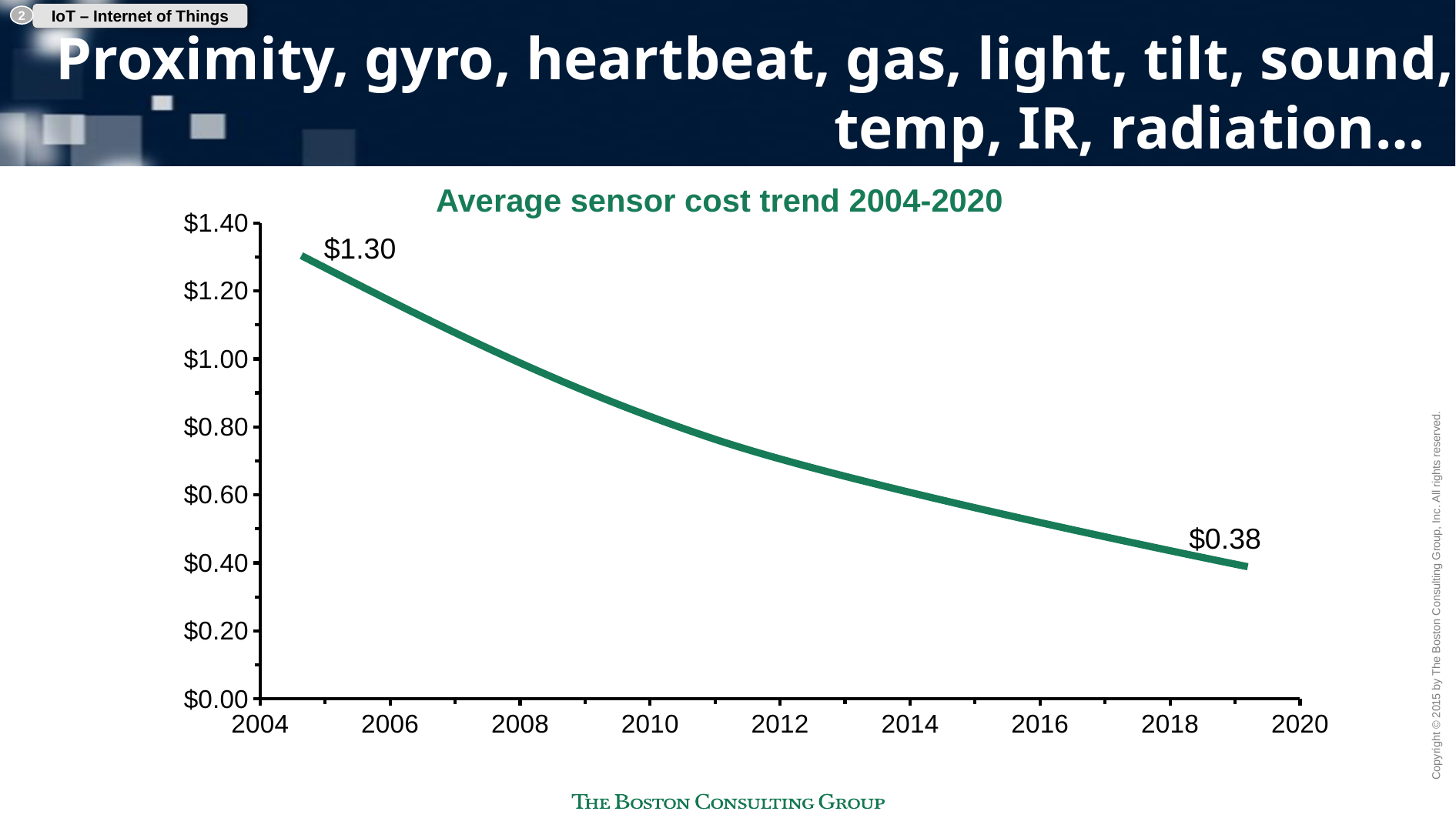
What is the difference between the starting value ($1.30) and the ending value ($0.38) of the line? $0.92 Is the value for 2010 greater or less than $1.00? less Does the average sensor cost rise or fall from 2004 to 2020? fall Is the value for 2006 greater or less than $1.00? greater What is the highest value labelled on the chart? $1.30 What is the value labelled at the end of the line? $0.38 What is the title of the chart? Average sensor cost trend 2004-2020 What is the value labelled at the start of the line? $1.30 What kind of chart is shown on the slide? line chart What is the lowest value labelled on the chart? $0.38 What is the maximum value shown on the y axis? $1.40 Is the value for 2014 greater or less than $0.80? less